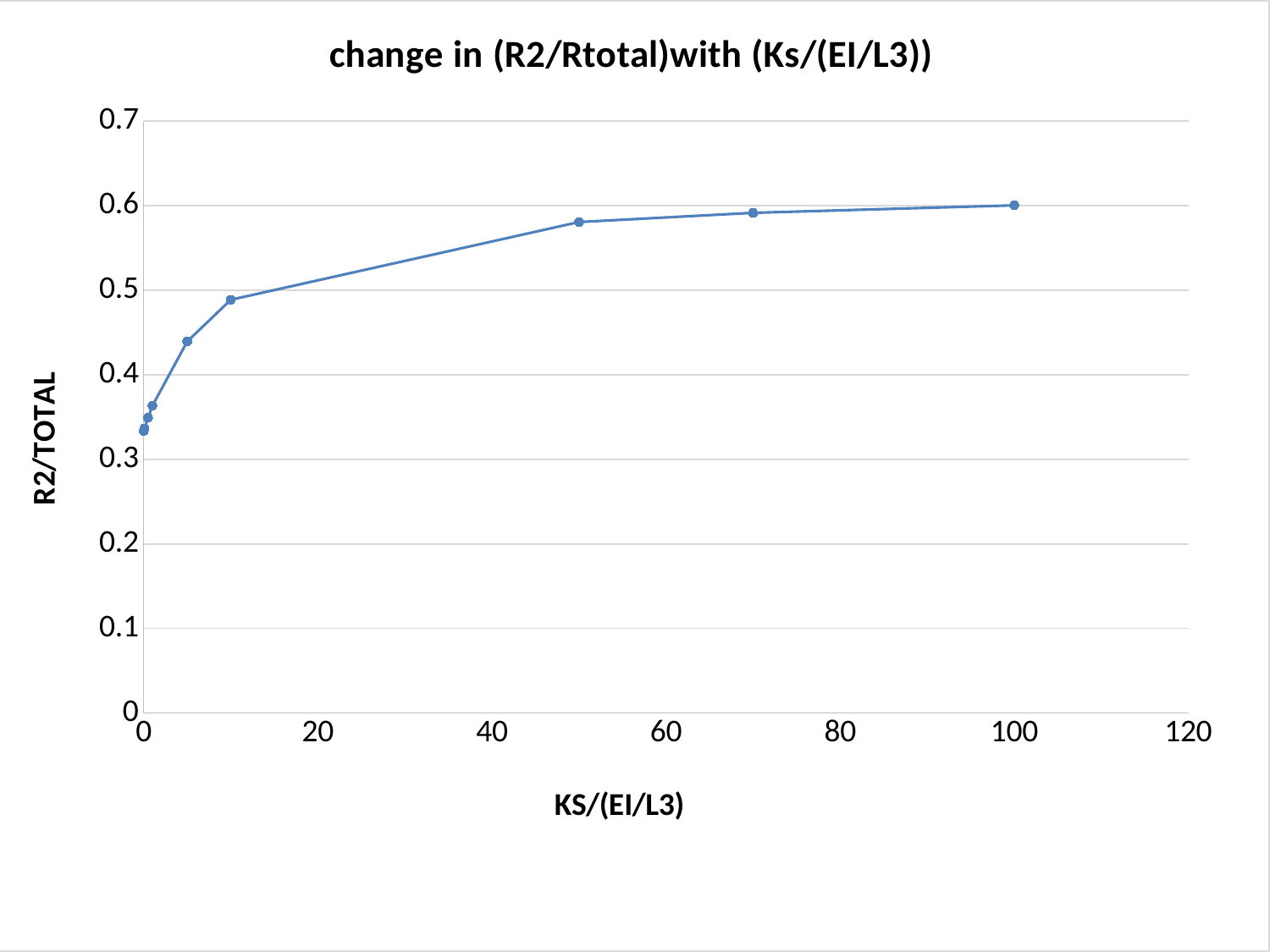
Is the value of R2/TOTAL at KS/(EI/L3) = 100 greater or less than 0.5? greater Which has the larger R2/TOTAL value: KS/(EI/L3) = 5 or KS/(EI/L3) = 100? KS/(EI/L3) = 100 Is the value of R2/TOTAL at KS/(EI/L3) = 50 greater or less than 0.5? greater What is the label of the vertical axis? R2/TOTAL What is the title of the chart? change in (R2/Rtotal)with (Ks/(EI/L3)) Is the value of R2/TOTAL at KS/(EI/L3) = 10 greater or less than 0.4? greater What kind of chart is shown on the slide? line chart Which has the larger R2/TOTAL value: KS/(EI/L3) = 10 or KS/(EI/L3) = 50? KS/(EI/L3) = 50 Do the values of R2/TOTAL rise or fall as KS/(EI/L3) increases? rise